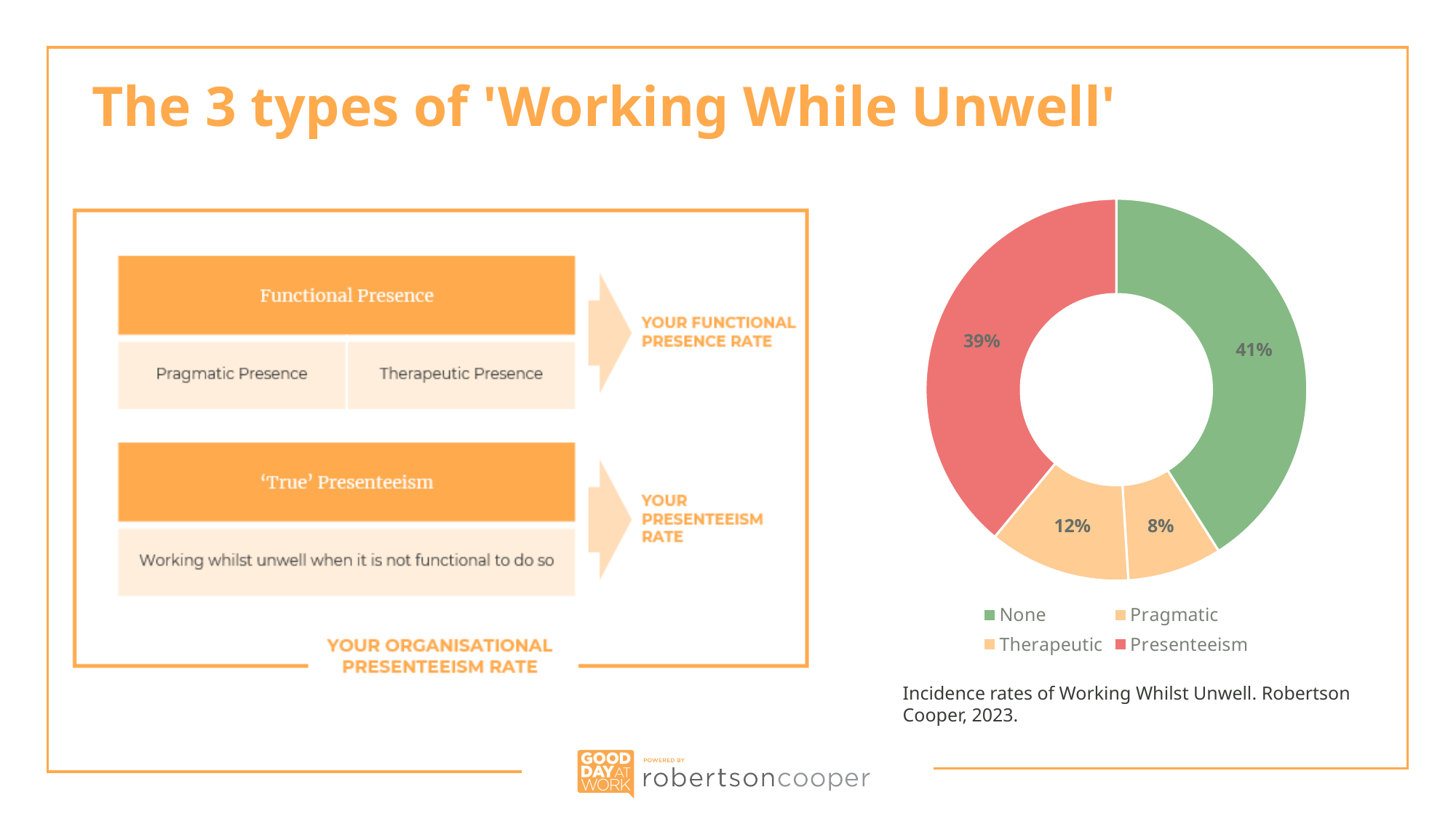
In the doughnut chart, which is larger: None or Presenteeism? None Which category has the largest share in the doughnut chart? None What is the combined share of the two smallest slices (12% and 8%) in the doughnut chart? 20% Which colour represents Presenteeism in the doughnut chart? Red What caption is given below the doughnut chart? Incidence rates of Working Whilst Unwell. Robertson Cooper, 2023. In the doughnut chart, what percentage is shown for None? 41% Is the share for Presenteeism in the doughnut chart greater or less than 50%? less What is the smallest percentage shown on the doughnut chart? 8% In the doughnut chart, what percentage is shown for Presenteeism? 39% What is the difference in percentage points between None and Presenteeism in the doughnut chart? 2 percentage points How many categories does the doughnut chart's legend list? 4 What kind of chart is shown on the right of the slide? Doughnut (pie) chart